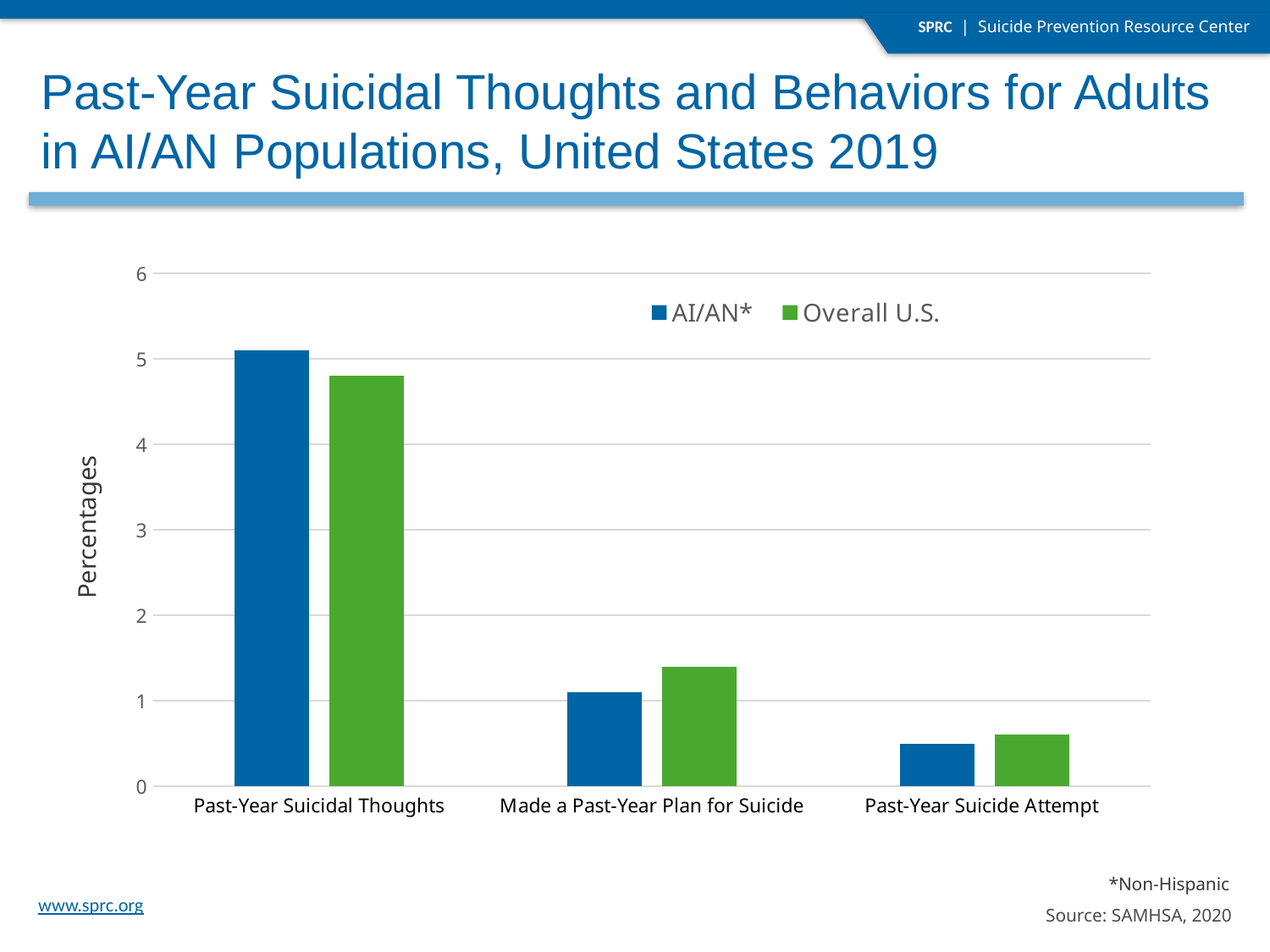
For Made a Past-Year Plan for Suicide, which series has the larger value, AI/AN* or Overall U.S.? Overall U.S. Is the Overall U.S. value for Past-Year Suicidal Thoughts greater or less than 5? less Is the AI/AN* value for Past-Year Suicide Attempt greater or less than 1? less How many series does the legend list? 2 Is the Overall U.S. value for Made a Past-Year Plan for Suicide greater or less than 1? greater Do the AI/AN* values rise or fall moving from left to right across the categories? fall What is the label on the vertical axis? Percentages How many categories are shown on the x axis? 3 Which category has the lowest value for the Overall U.S. series? Past-Year Suicide Attempt What kind of chart is shown on the slide? Bar chart Which category has the highest value for the AI/AN* series? Past-Year Suicidal Thoughts For Past-Year Suicidal Thoughts, which series has the larger value, AI/AN* or Overall U.S.? AI/AN*